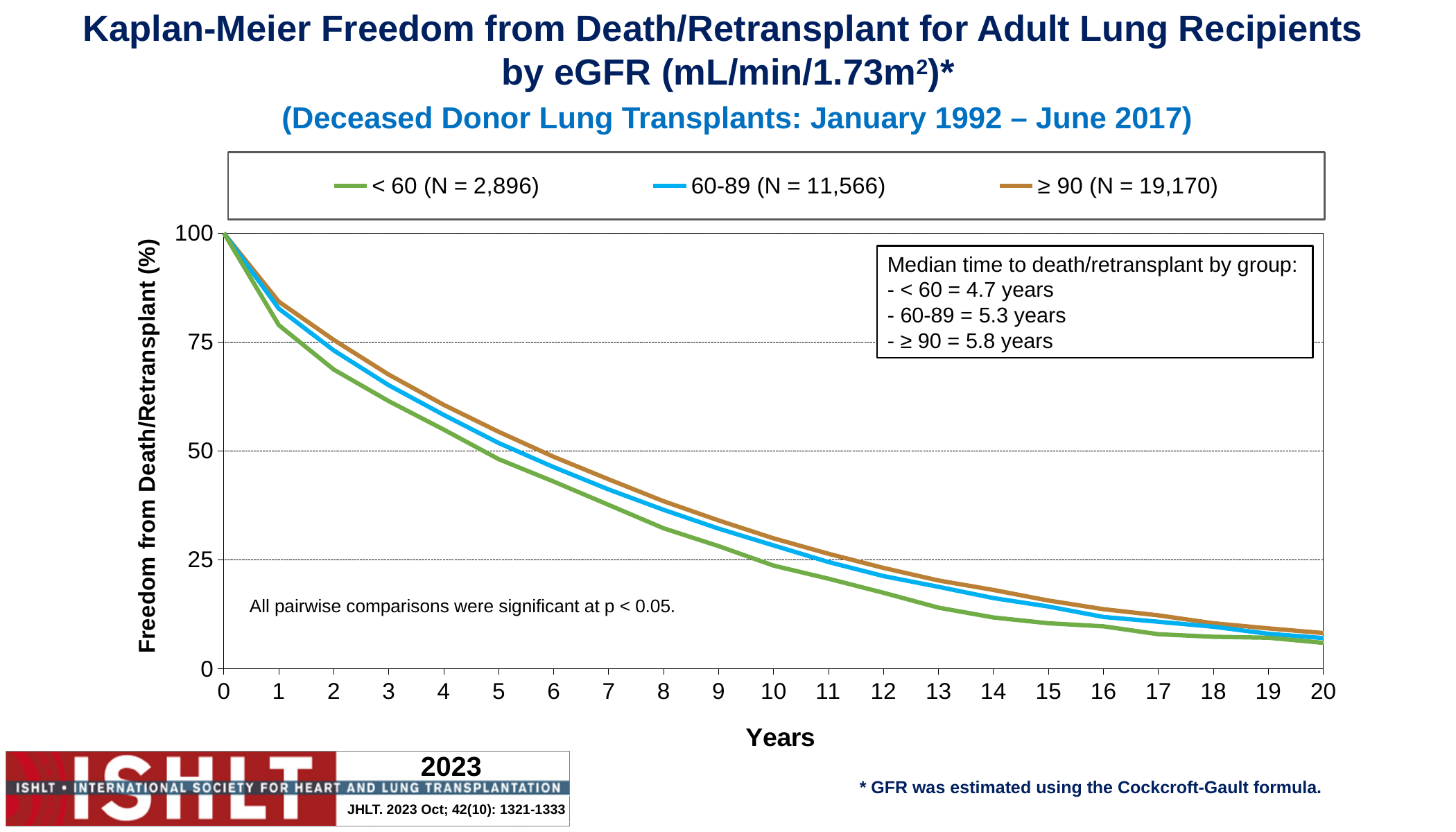
Is the freedom from death/retransplant for the < 60 group at 10 years greater or less than 25? less What is the median time to death/retransplant for the < 60 eGFR group? 4.7 years At 10 years, which group has higher freedom from death/retransplant, < 60 or ≥ 90? ≥ 90 What is the N for the 60-89 eGFR group shown in the legend? 11,566 What is the median time to death/retransplant for the ≥ 90 eGFR group? 5.8 years Is the freedom from death/retransplant for the ≥ 90 group at 1 year greater or less than 75? greater How many series does the legend list? 3 What kind of chart is shown on the slide? Line chart Which eGFR group has the longest median time to death/retransplant? ≥ 90 What is the median time to death/retransplant for the 60-89 eGFR group? 5.3 years Do the curves rise or fall as the years increase along the x axis? Fall What is the difference in median time to death/retransplant between the ≥ 90 group and the < 60 group? 1.1 years